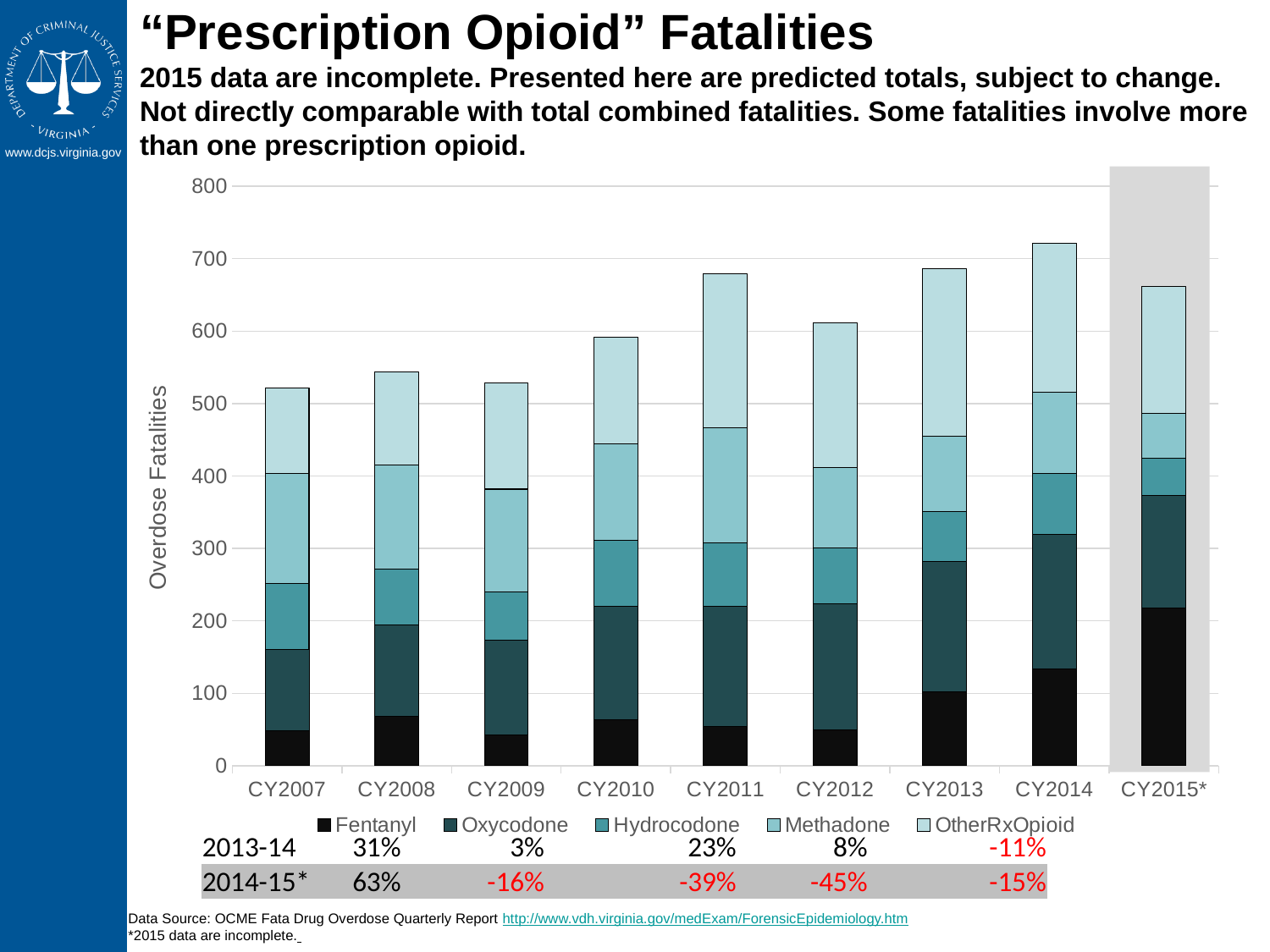
Is the Fentanyl value for CY2014 greater or less than 100? greater Which year has the highest total overdose fatalities in the chart? CY2014 What is the title of the chart on the slide? "Prescription Opioid" Fatalities Is the Fentanyl value for CY2007 greater or less than 100? less Is the total overdose fatalities for CY2007 greater or less than 500? greater How many years (categories) are shown on the x axis of the chart? 9 How many series does the chart legend list? 5 Which year has the larger total overdose fatalities, CY2009 or CY2010? CY2010 What kind of chart is shown on the slide? stacked bar chart Which series is plotted at the bottom of each stacked bar? Fentanyl